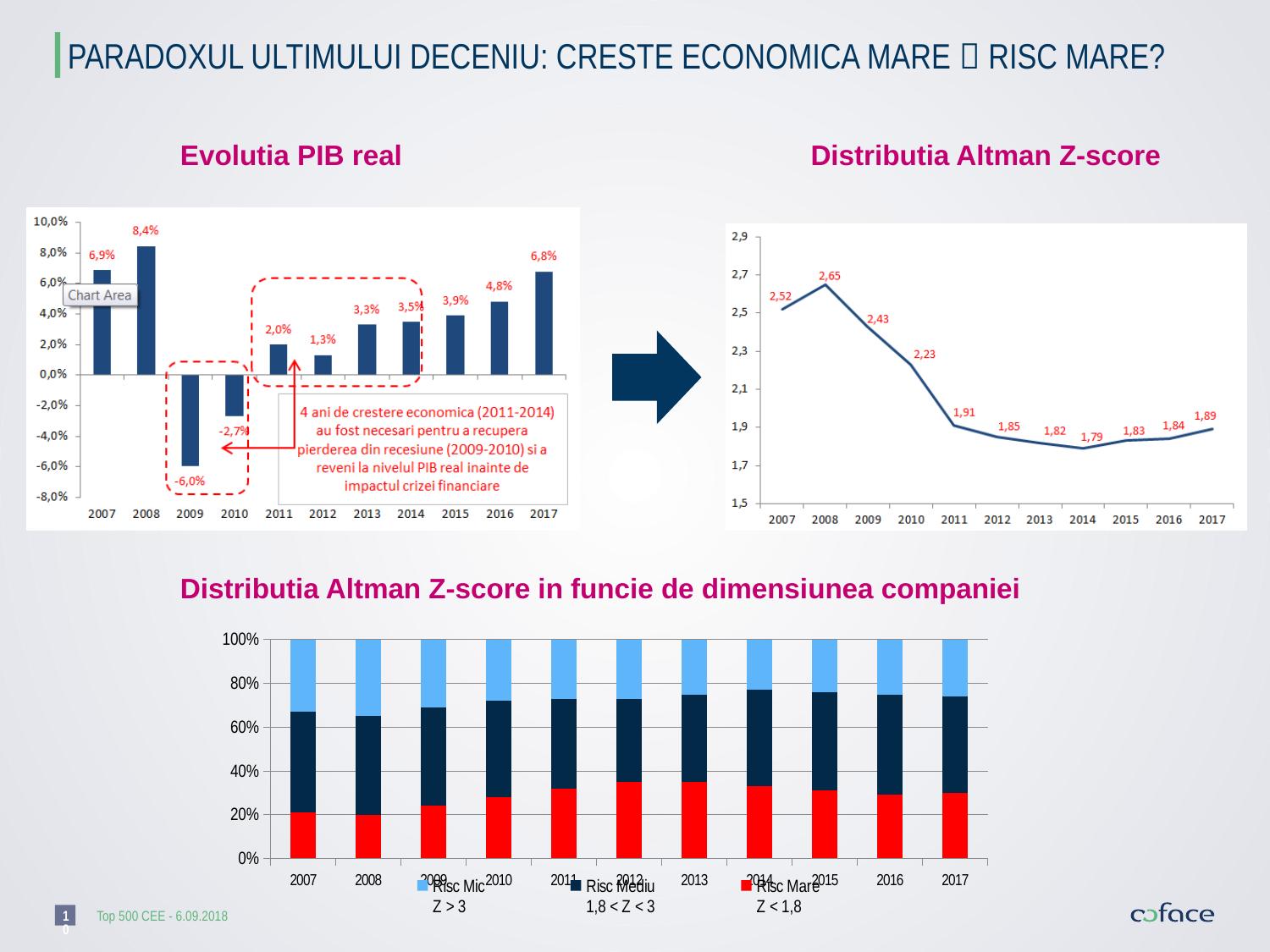
In the 'Evolutia PIB real' chart, what is the difference between the values for 2017 and 2016? 2,0% In the 'Evolutia PIB real' chart, what is the value for 2009? -6,0% In the 'Evolutia PIB real' chart, what is the value for 2008? 8,4% In the 'Distributia Altman Z-score in funcie de dimensiunea companiei' chart, is the 'Risc Mare' share for 2007 greater or less than 40%? less In the 'Distributia Altman Z-score in funcie de dimensiunea companiei' chart, how many series does the legend list? 3 In the 'Distributia Altman Z-score' chart, is the value for 2010 larger or the value for 2011? 2010 In the 'Evolutia PIB real' chart, which year has the lowest value? 2009 In the 'Evolutia PIB real' chart, how many years are shown on the x axis? 11 In the 'Distributia Altman Z-score' chart, which year has the highest value? 2008 In the 'Evolutia PIB real' chart, which year has the highest value? 2008 In the 'Distributia Altman Z-score' chart, what is the value for 2014? 1,79 In the 'Distributia Altman Z-score' chart, what kind of chart is it? line chart